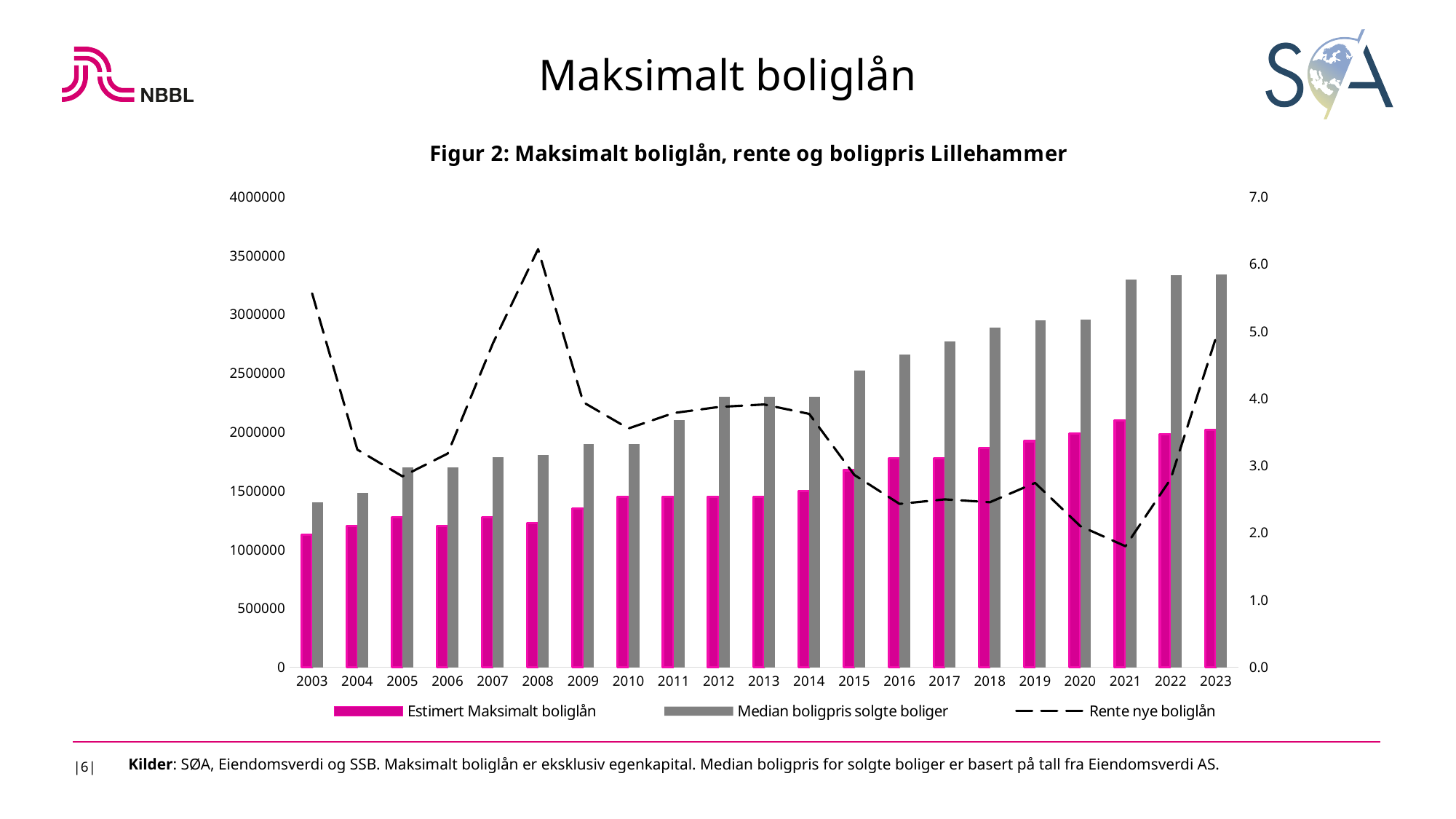
In which year is the Estimert Maksimalt boliglån bar highest? 2021 Does the Median boligpris solgte boliger series generally rise or fall from 2003 to 2023? Rise In which year does the Rente nye boliglån line reach its highest point? 2008 In which year is the Estimert Maksimalt boliglån bar lowest? 2003 What kind of chart is shown in Figur 2? A combined bar and line chart Is the Median boligpris solgte boliger value for 2023 greater or less than 3000000? greater How many years are shown on the x axis? 21 How many series does the legend list? 3 Which is larger in 2015: Estimert Maksimalt boliglån or Median boligpris solgte boliger? Median boligpris solgte boliger In which year does the Rente nye boliglån line reach its lowest point? 2021 In which year is the Median boligpris solgte boliger bar lowest? 2003